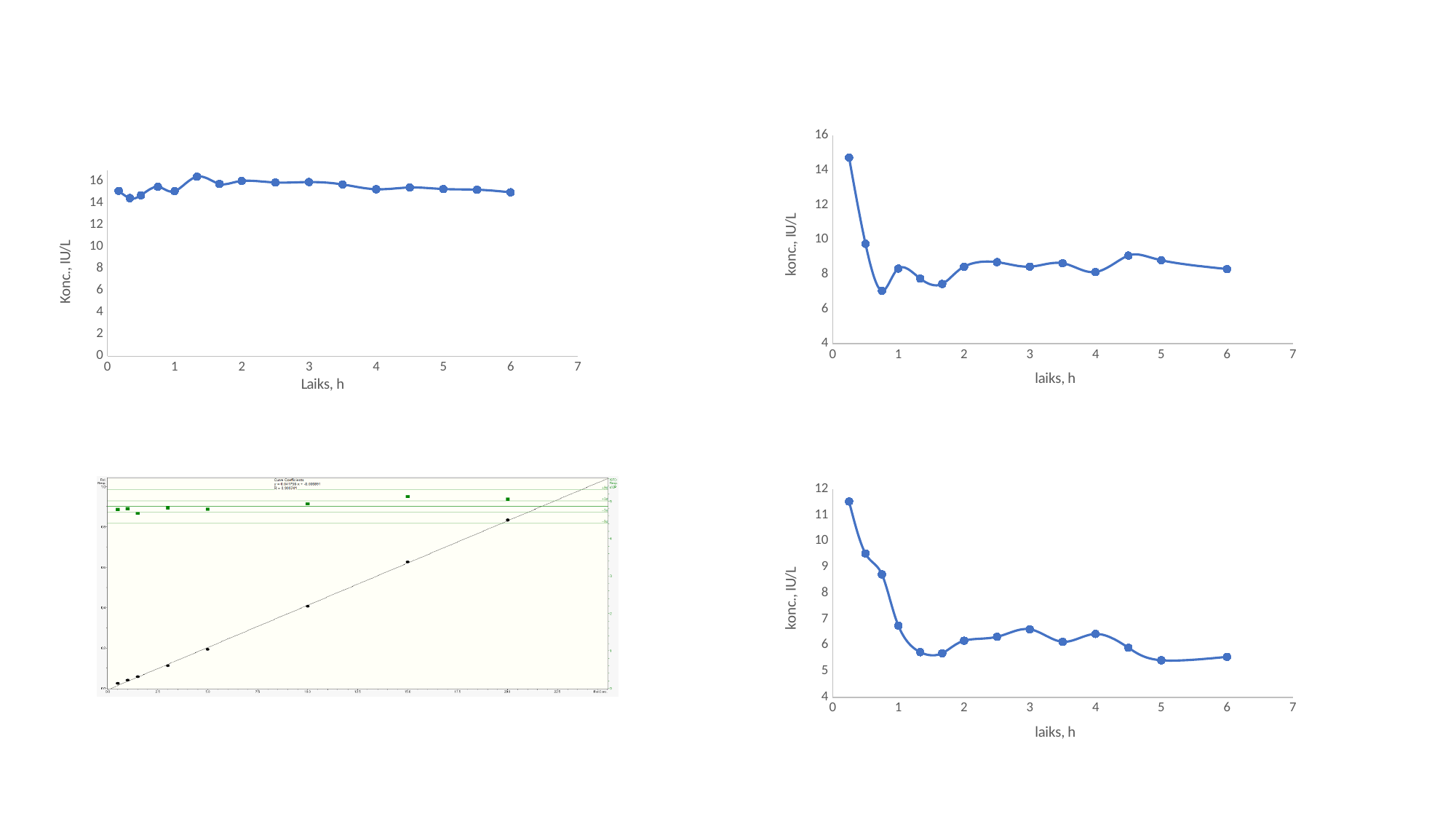
How many data points are plotted in the top-right chart? 14 In the bottom-right chart, is the value at 5 h greater or less than 6? less In the top-right chart, at which time (h) is the concentration highest? 0.25 In the top-right chart, is the value at 0.25 h greater or less than 12? greater What is the x-axis label of the top-left chart? Laiks, h What is the y-axis label of the bottom-right chart? konc., IU/L How many data points are plotted in the top-left chart? 16 What type of chart is the top-left chart on the slide? line chart In the top-right chart, do the values overall rise or fall from 0.25 h to 6 h? fall In the top-left chart, is the value at 6 h greater or less than 12? greater In the top-right chart, at which time (h) is the concentration lowest? 0.75 In the bottom-right chart, which is larger, the value at 0.25 h or the value at 6 h? 0.25 h